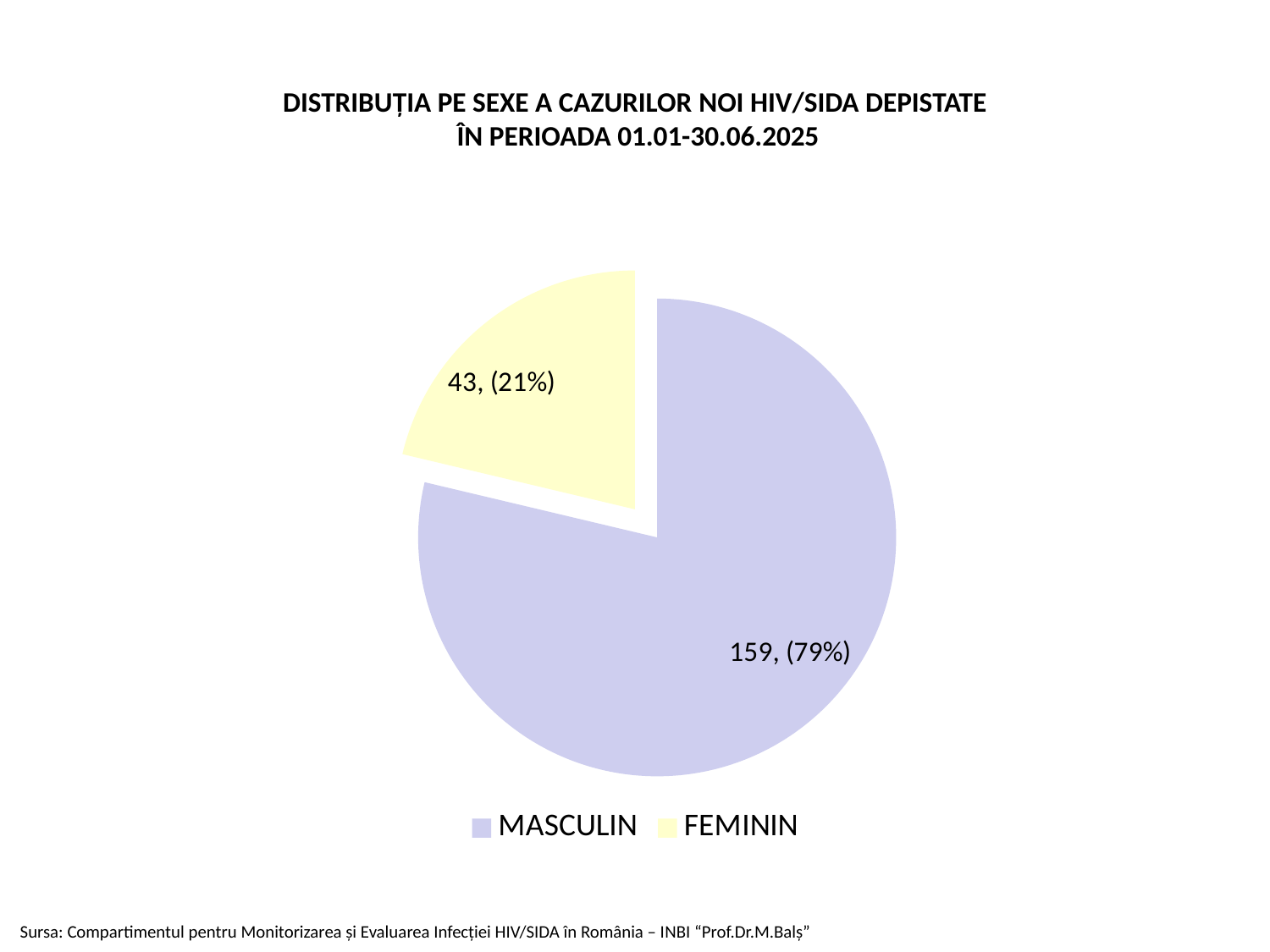
How many cases are shown for FEMININ? 43 What is the total number of cases shown in the pie chart? 202 What percentage share of the pie does the FEMININ slice represent? 21% What percentage share of the pie does the MASCULIN slice represent? 79% Which category has the smallest slice of the pie? FEMININ How many categories does the pie chart have? 2 What is the difference between the number of MASCULIN cases and FEMININ cases? 116 What kind of chart is shown on the slide? pie chart How many cases are shown for MASCULIN? 159 Which is larger, the number of MASCULIN cases or the number of FEMININ cases? MASCULIN What colour is the FEMININ slice in the pie chart? light yellow Which category has the largest slice of the pie? MASCULIN